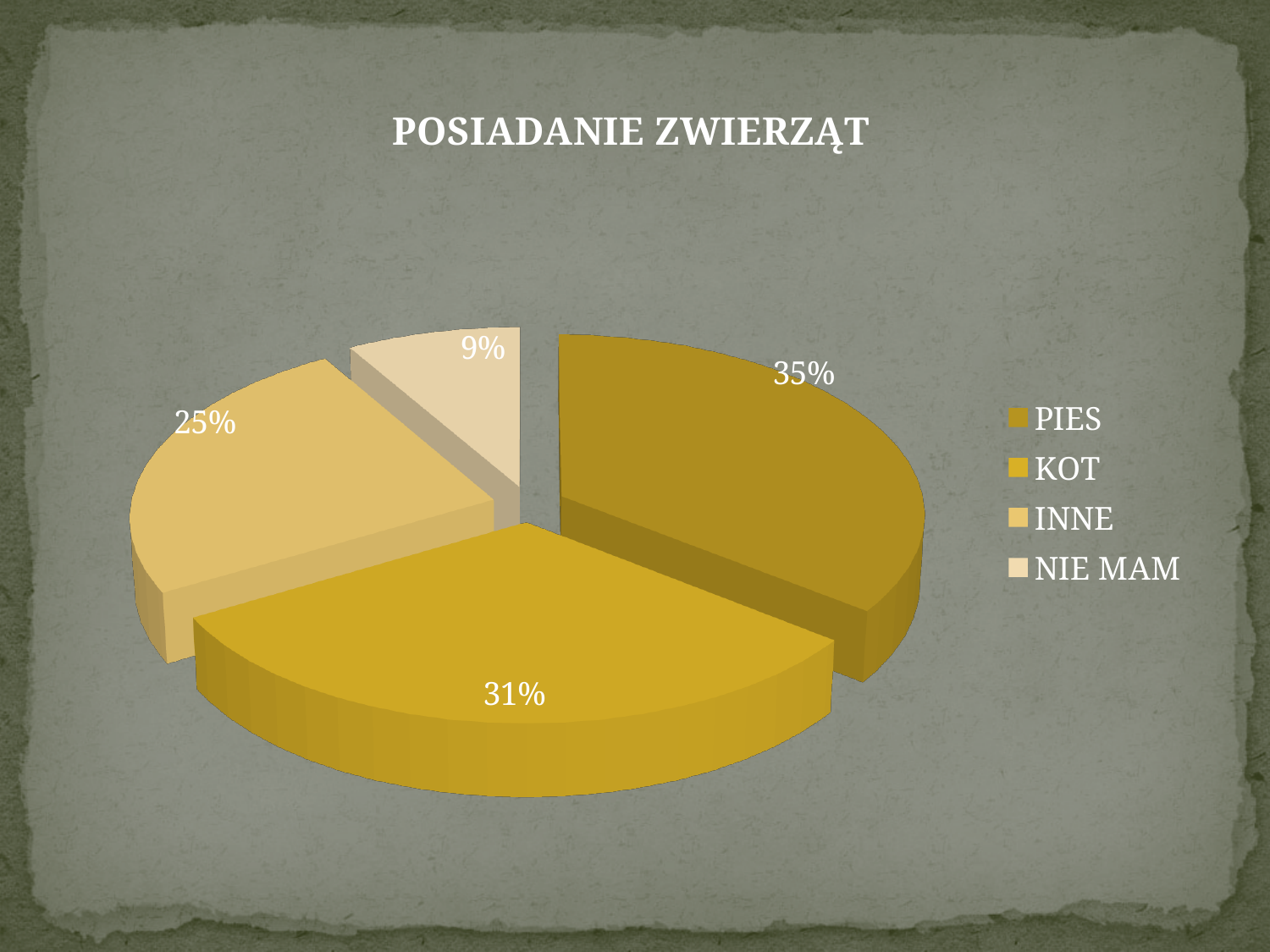
What percentage of the pie does INNE represent? 25% What is the difference in percentage points between INNE and NIE MAM? 16 Which category has the largest share of the pie? PIES What is the difference in percentage points between PIES and KOT? 4 What percentage of the pie does PIES represent? 35% What is the title of the chart? POSIADANIE ZWIERZĄT Which category has the smallest share of the pie? NIE MAM Which is larger, the share for KOT or the share for INNE? KOT What percentage of the pie does NIE MAM represent? 9% What type of chart is shown on the slide? Pie chart How many slices does the pie chart have? 4 What percentage of the pie does KOT represent? 31%